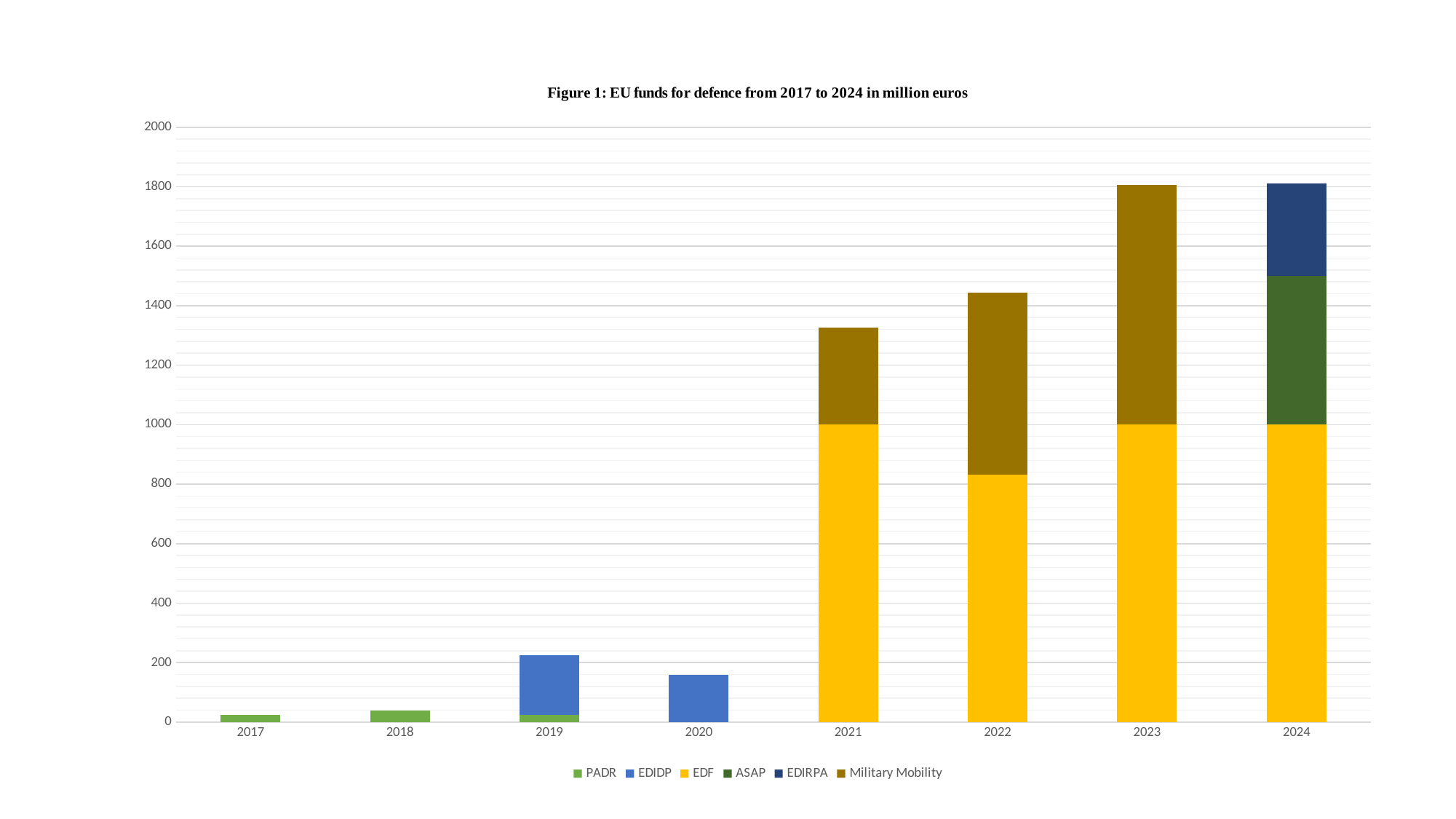
What kind of chart is shown on the slide? Stacked bar chart Is the total value for 2022 greater or less than 1600? less Which year has the larger total, 2019 or 2020? 2019 How many series does the legend list? 6 How many years are shown on the x axis of the chart? 8 Do the total values generally rise or fall from 2017 to 2024? rise Is the EDF value for 2022 greater or less than 1000? less Which year has the lowest total EU defence funding in the chart? 2017 Is the total value for 2020 greater or less than 200? less What is the title of the chart? Figure 1: EU funds for defence from 2017 to 2024 in million euros Which two series appear in the 2024 bar but not in the 2023 bar? ASAP and EDIRPA